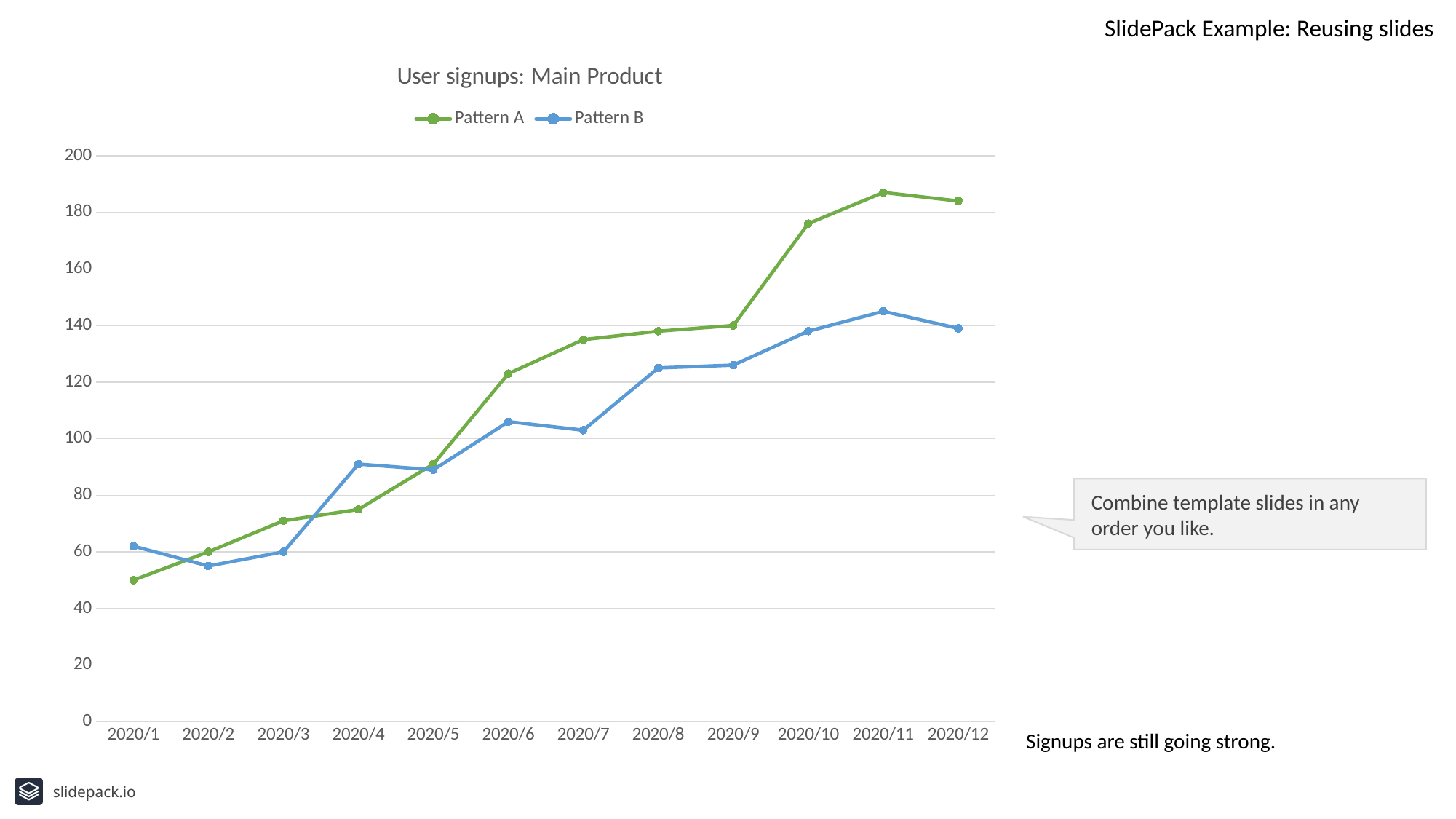
In which month does Pattern B reach its highest value? 2020/11 Which series is drawn in green? Pattern A In which month does Pattern A reach its highest value? 2020/11 How many points are plotted along the x axis for each series? 12 Do the values for Pattern A generally rise or fall from 2020/1 to 2020/11? rise Which series has the larger value in 2020/4, Pattern A or Pattern B? Pattern B How many series does the legend list? 2 Is the value for Pattern A in 2020/10 greater or less than 160? greater What kind of chart is shown on the slide? line chart What is the title of the chart? User signups: Main Product In which month is Pattern A at its lowest value? 2020/1